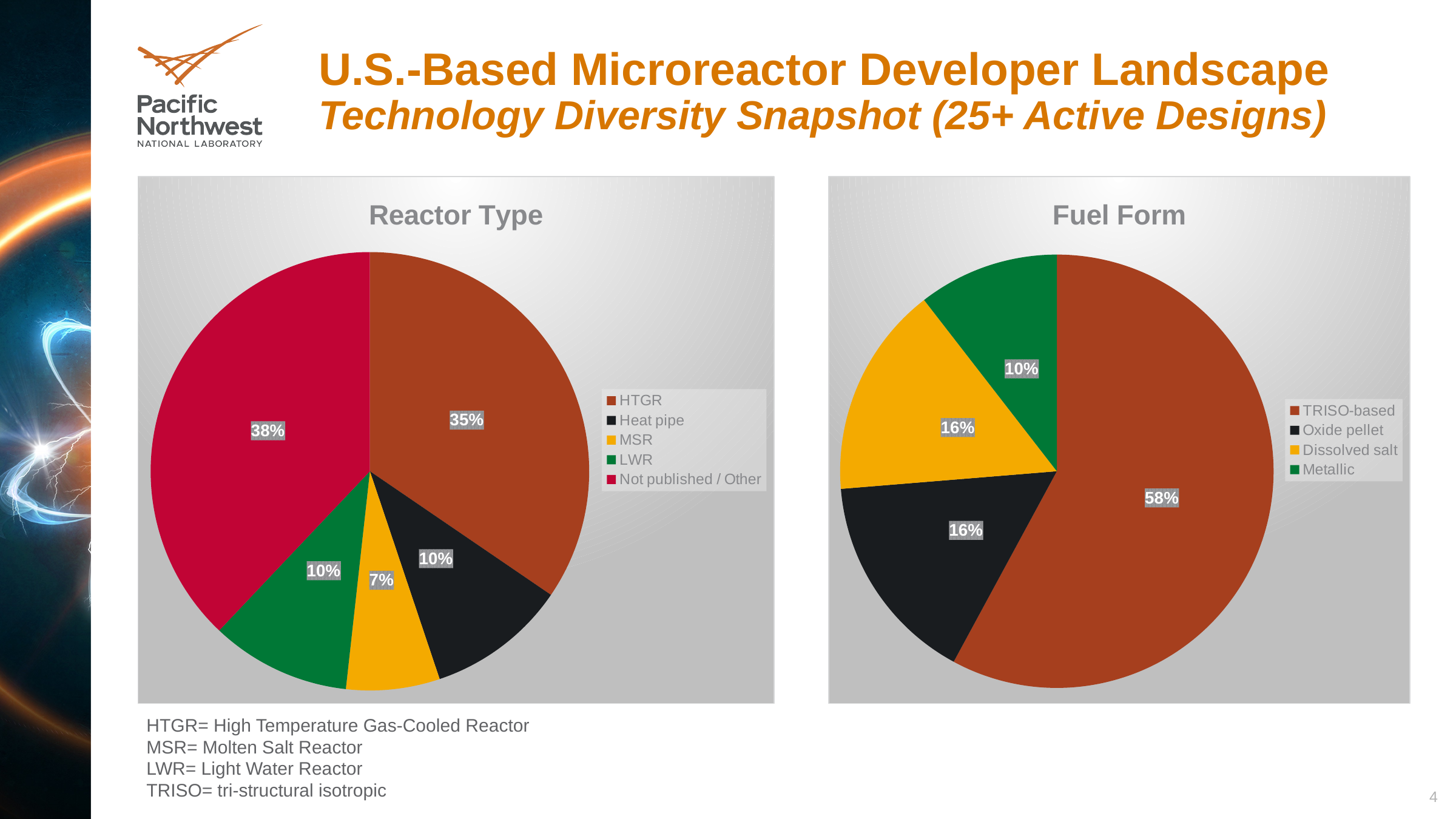
In the Fuel Form chart, what is the difference in percentage points between TRISO-based and Dissolved salt? 42 In the Reactor Type chart, which category has the largest slice? Not published / Other In the Reactor Type chart, what share of designs is HTGR? 35% In the Reactor Type chart, how many categories does the legend list? 5 In the Fuel Form chart, what share of designs is Metallic? 10% In the Reactor Type chart, what share of designs is MSR? 7% In the Fuel Form chart, which category has the largest slice? TRISO-based In the Fuel Form chart, what share of designs is TRISO-based? 58% In the Fuel Form chart, which is larger, Oxide pellet or Metallic? Oxide pellet What kind of chart is the Fuel Form chart? Pie chart In the Reactor Type chart, which category has the smallest slice? MSR In the Reactor Type chart, what is the difference in percentage points between Not published / Other and HTGR? 3